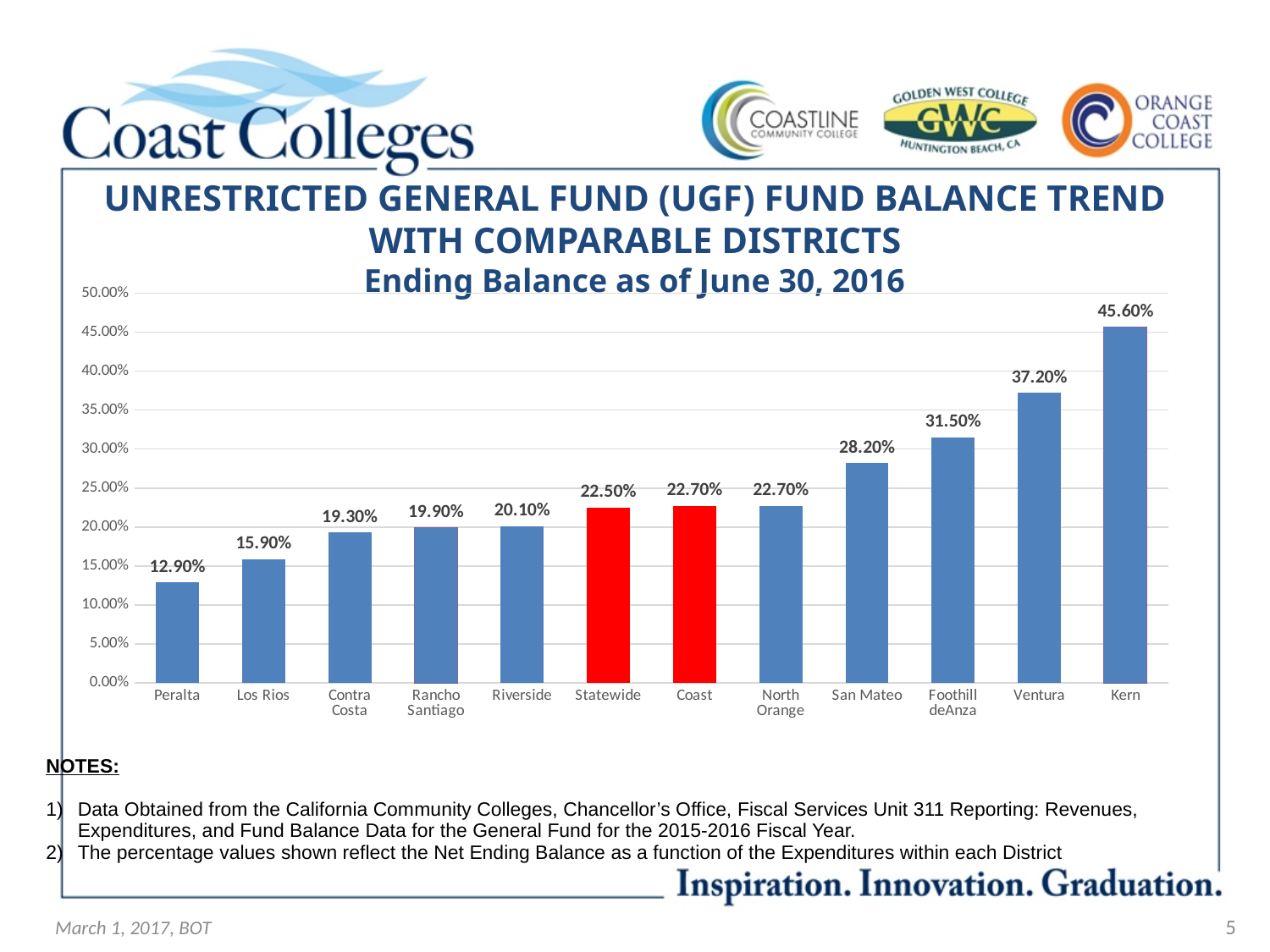
What is the difference between Kern's value and Ventura's value? 8.40% Which district has the lowest ending balance percentage? Peralta Which two bars are coloured red instead of blue? Statewide and Coast Which is larger, the value for San Mateo or the value for North Orange? San Mateo How many districts or categories are shown on the x axis? 12 What kind of chart is shown on the slide? bar chart Which district has the highest ending balance percentage? Kern What is the difference between the Coast value and the Statewide value? 0.20% What is the ending balance percentage for Coast? 22.70% Is the value for Riverside greater or less than 25.00%? less What is the ending balance percentage for Peralta? 12.90% What is the value shown for Foothill deAnza? 31.50%